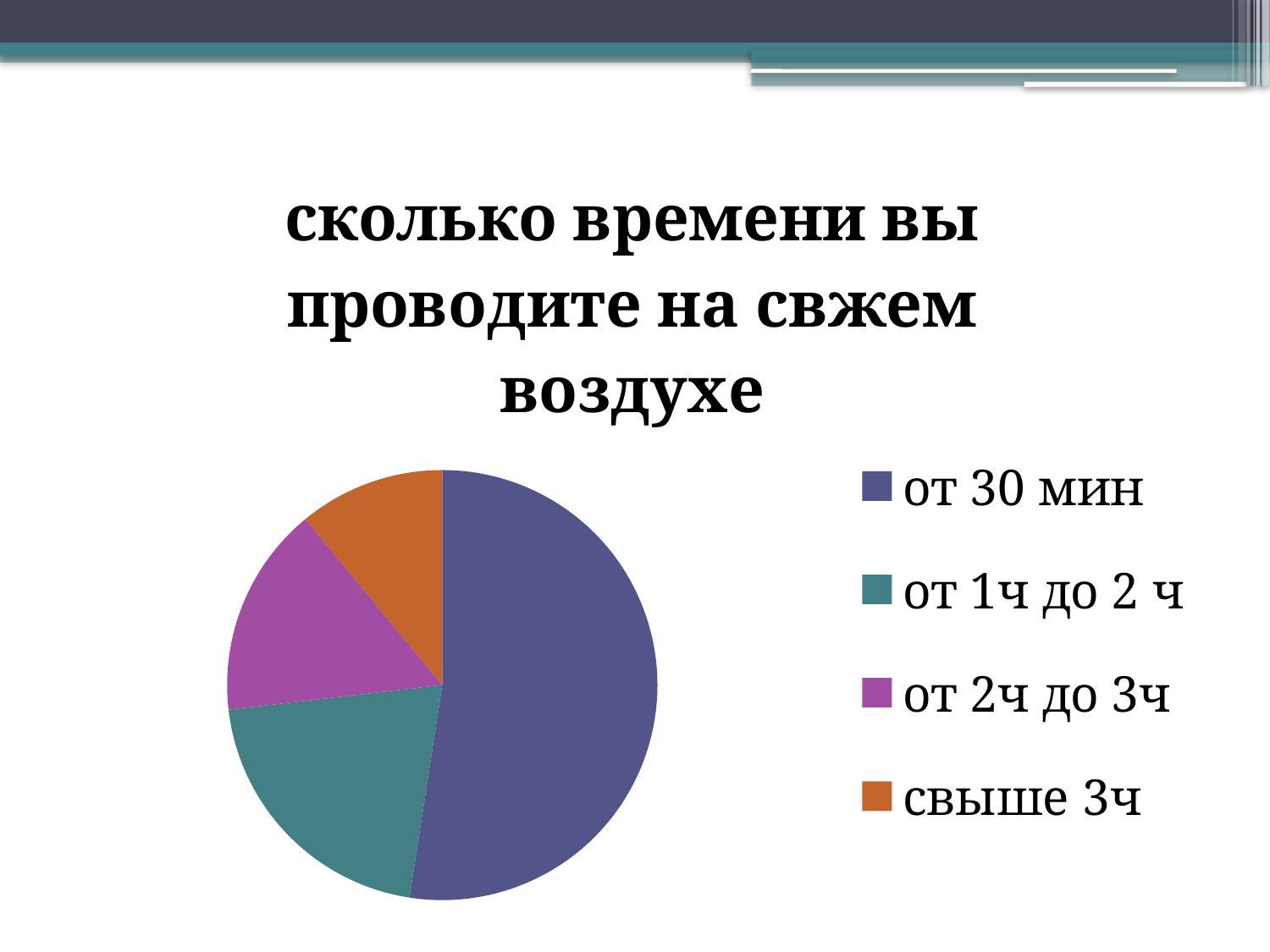
Which slice is larger: "от 30 мин" or "от 1ч до 2 ч"? от 30 мин How many entries does the legend list? 4 How many slices does the pie chart have? 4 Which category is shown in orange in the legend? свыше 3ч What is the title of the chart? сколько времени вы проводите на свжем воздухе Which slice is larger: "от 1ч до 2 ч" or "свыше 3ч"? от 1ч до 2 ч What kind of chart is shown on the slide? pie chart Which category has the smallest slice of the pie? свыше 3ч Which category has the largest slice of the pie? от 30 мин Which slice is larger: "от 2ч до 3ч" or "от 30 мин"? от 30 мин